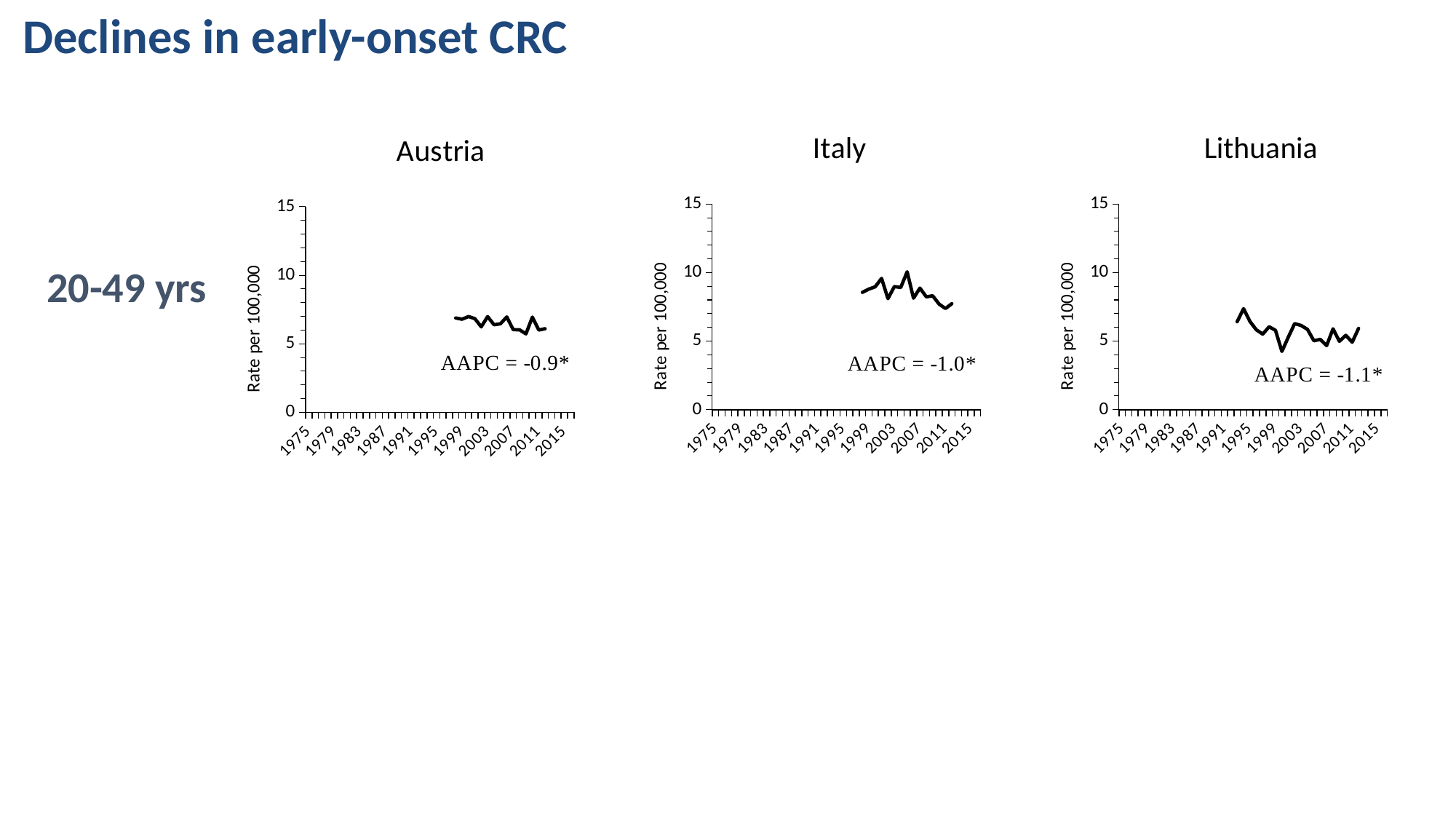
How many country charts are shown on the slide? 3 Around 2003, which country has the higher rate, Italy or Austria? Italy What is the y-axis label on the Lithuania chart? Rate per 100,000 On the Italy chart, is the rate in 2011 greater or less than 10? less On the Italy chart, does the rate generally rise or fall from 2007 to 2011? fall On the Lithuania chart, is the rate in 2007 greater or less than 10? less Which of the three countries has the most negative AAPC printed on its chart? Lithuania On the Lithuania chart, what AAPC value is printed? AAPC = -1.1* On the Austria chart, what AAPC value is printed? AAPC = -0.9* On the Austria chart, is the rate in 1999 greater or less than 5? greater On the Italy chart, what AAPC value is printed? AAPC = -1.0* What kind of chart is the Austria chart? line chart